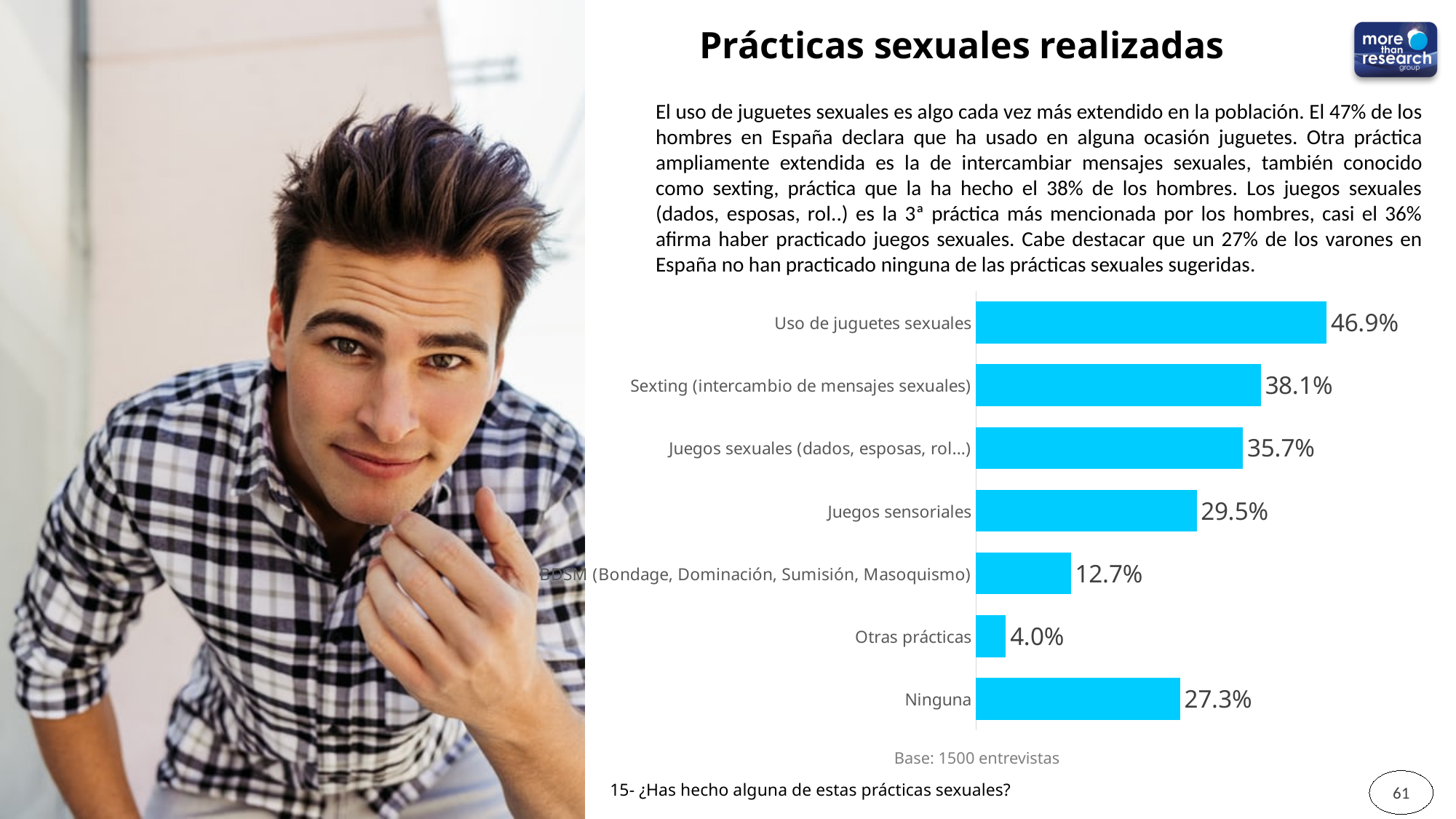
What is the value for Uso de juguetes sexuales? 46.9% What is the difference between BDSM (Bondage, Dominación, Sumisión, Masoquismo) and Otras prácticas? 8.7% What base (number of interviews) is stated below the chart? 1500 entrevistas What kind of chart is shown on the slide? Bar chart What is the difference between Uso de juguetes sexuales and Sexting (intercambio de mensajes sexuales)? 8.8% How many categories are shown in the chart? 7 Which category has the highest value? Uso de juguetes sexuales Which is larger, Juegos sensoriales or Ninguna? Juegos sensoriales What is the value for Juegos sensoriales? 29.5% What is the value for Sexting (intercambio de mensajes sexuales)? 38.1% Which category has the lowest value? Otras prácticas What is the value for Ninguna? 27.3%